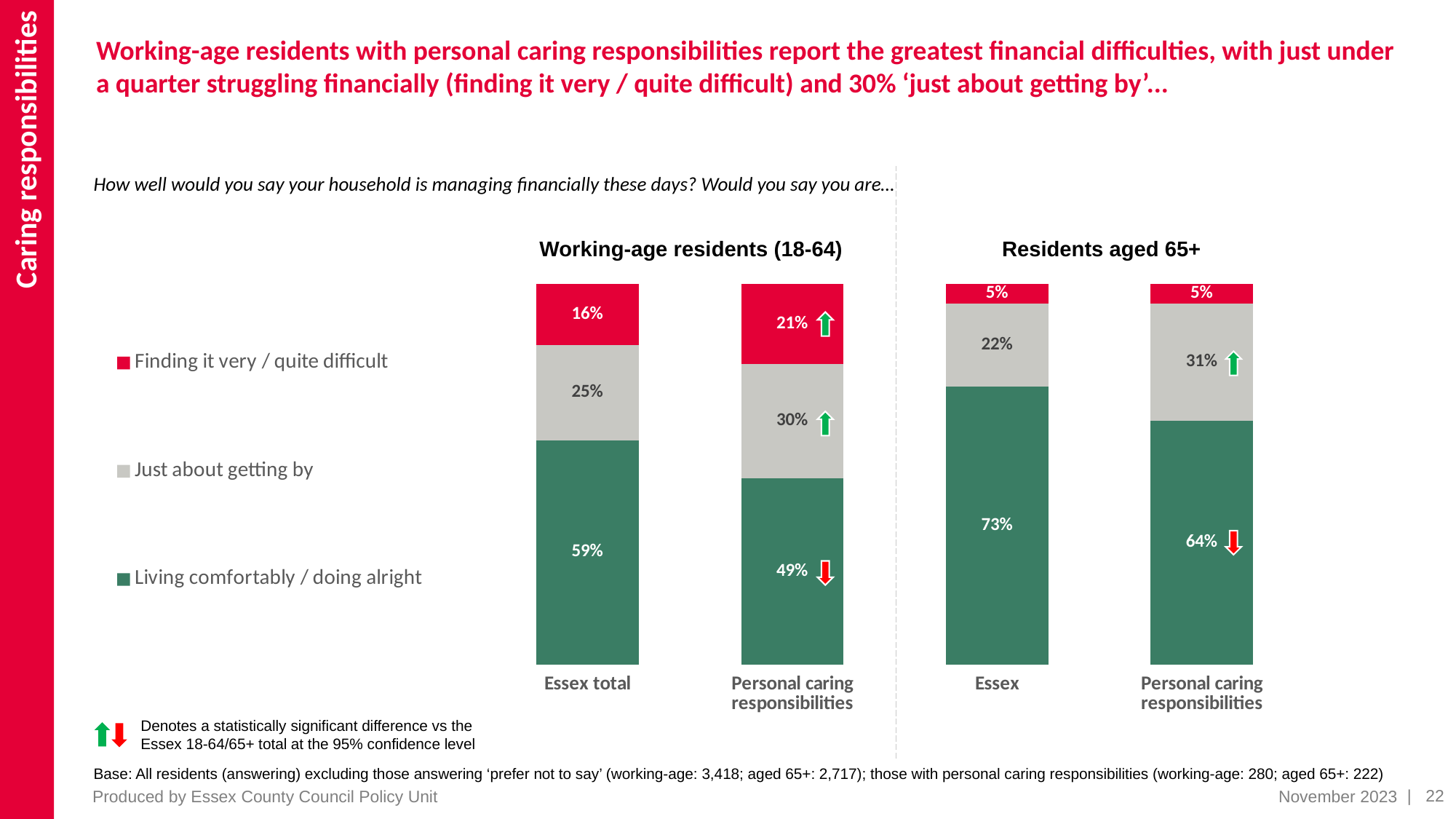
In the 'Residents aged 65+' chart, what percentage of those with personal caring responsibilities are 'Just about getting by'? 31% How many series does the legend list? 3 In the 'Working-age residents (18-64)' chart, what percentage of those with personal caring responsibilities are 'Living comfortably / doing alright'? 49% In the 'Residents aged 65+' chart, what is the difference in the 'Just about getting by' share between those with personal caring responsibilities and Essex? 9% What type of chart is used on this slide? Stacked bar chart In the 'Working-age residents (18-64)' chart, which bar has the larger 'Finding it very / quite difficult' share: Essex total or Personal caring responsibilities? Personal caring responsibilities In the 'Working-age residents (18-64)' chart, what percentage of the Essex total are 'Finding it very / quite difficult'? 16% In the 'Residents aged 65+' chart, what percentage of Essex residents are 'Living comfortably / doing alright'? 73% In the 'Working-age residents (18-64)' chart, which segment of the Essex total bar is the largest? Living comfortably / doing alright In the 'Residents aged 65+' chart, which segment of the Personal caring responsibilities bar is the smallest? Finding it very / quite difficult In the 'Residents aged 65+' chart, which bar has the larger 'Living comfortably / doing alright' share: Essex or Personal caring responsibilities? Essex In the 'Working-age residents (18-64)' chart, what is the difference in the 'Living comfortably / doing alright' share between the Essex total and those with personal caring responsibilities? 10%